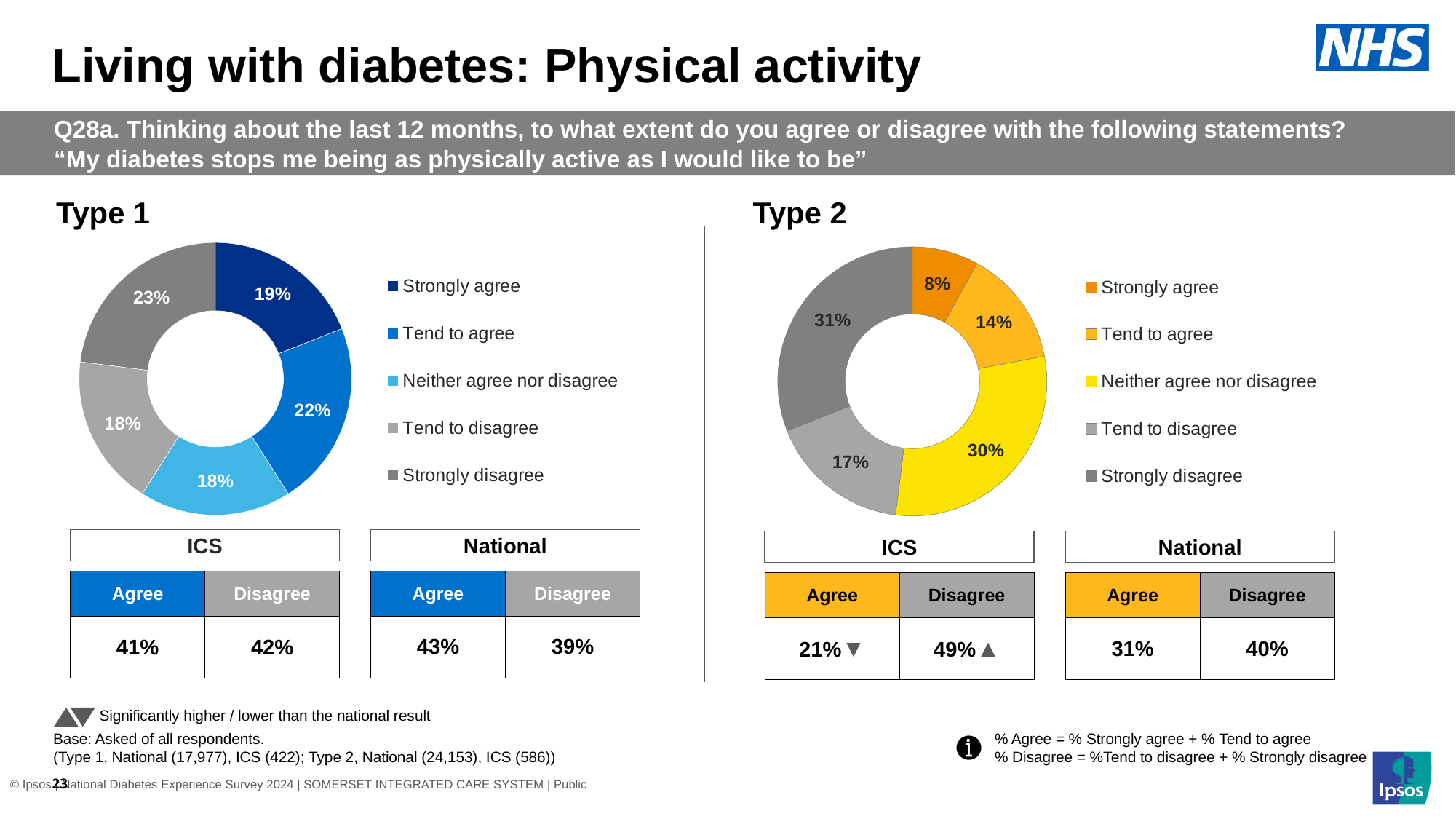
In the Type 2 chart, what is the difference in percentage points between strongly disagree and strongly agree? 23 In the Type 2 chart, which response category has the smallest share? Strongly agree In the Type 2 chart, which response category has the largest share? Strongly disagree In the Type 2 chart, what colour represents the 'Neither agree nor disagree' category? Yellow In the Type 2 chart, what percentage of respondents said they neither agree nor disagree? 30% In the Type 2 chart, what percentage of respondents said they tend to agree? 14% In the Type 1 chart, which response category has the largest share? Strongly disagree In the Type 1 chart, what percentage of respondents said they strongly agree? 19% What type of chart is used to show the Type 2 results? Donut (pie) chart In the Type 1 chart, which is larger: the share for tend to agree or the share for strongly agree? Tend to agree How many response categories does the legend of the Type 1 chart list? 5 In the Type 1 chart, what percentage of respondents said they tend to disagree? 18%